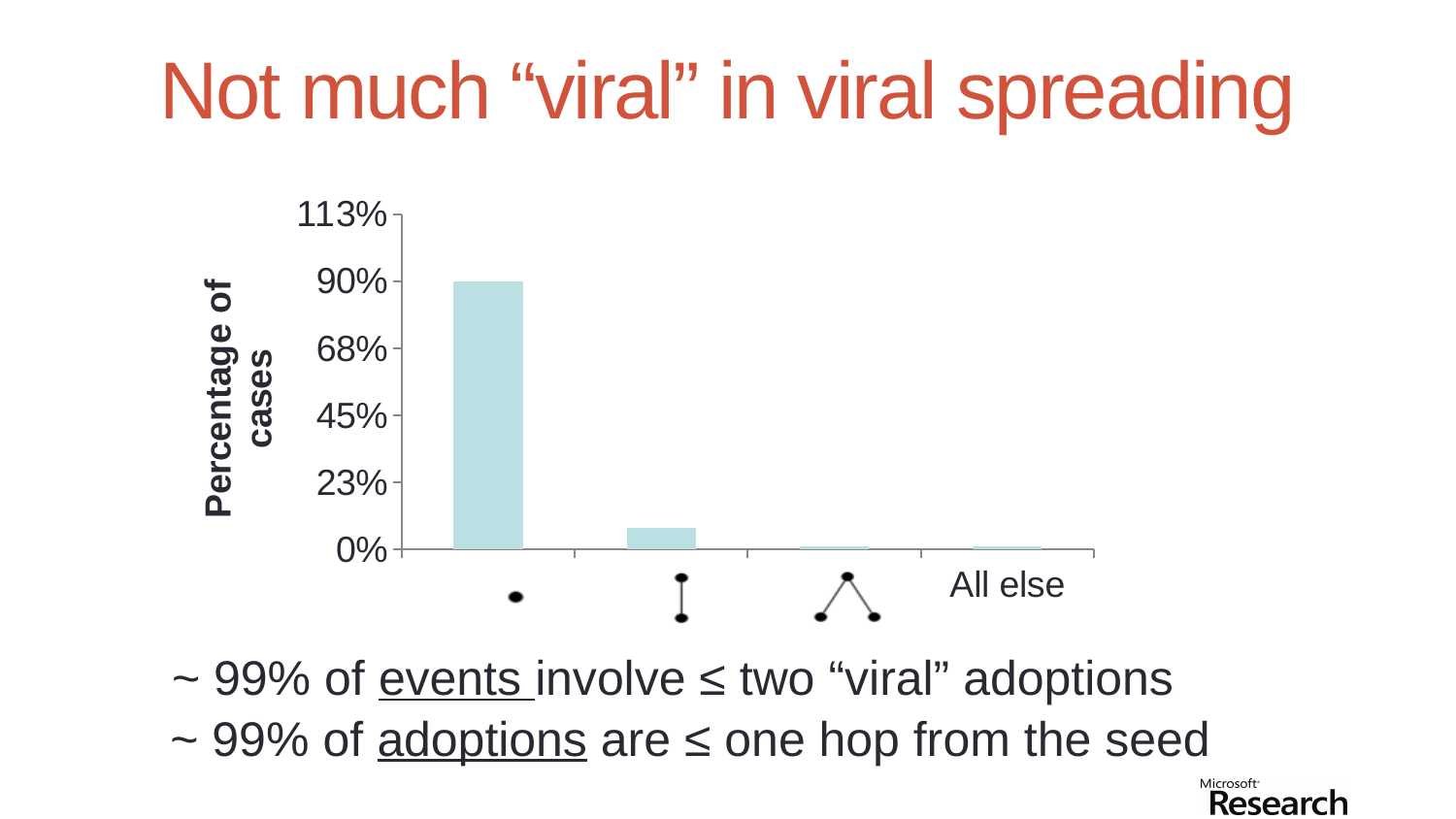
Do the bar values rise or fall from left to right along the x axis? fall How many bars (categories) does the chart have? 4 What is the title of the y axis? Percentage of cases Is the value for the second bar from the left greater or less than 23%? less Which is larger: the second bar from the left or 'All else'? the second bar from the left What is the highest tick label shown on the y axis? 113% What kind of chart is shown on the slide? bar chart Which category has the highest percentage of cases? the first bar from the left (single node) Which is larger: the first bar from the left or the second bar from the left? the first bar from the left Is the value for the first bar from the left greater or less than 68%? greater What is the percentage of cases for the first bar from the left? 90% Is the value for 'All else' greater or less than 23%? less